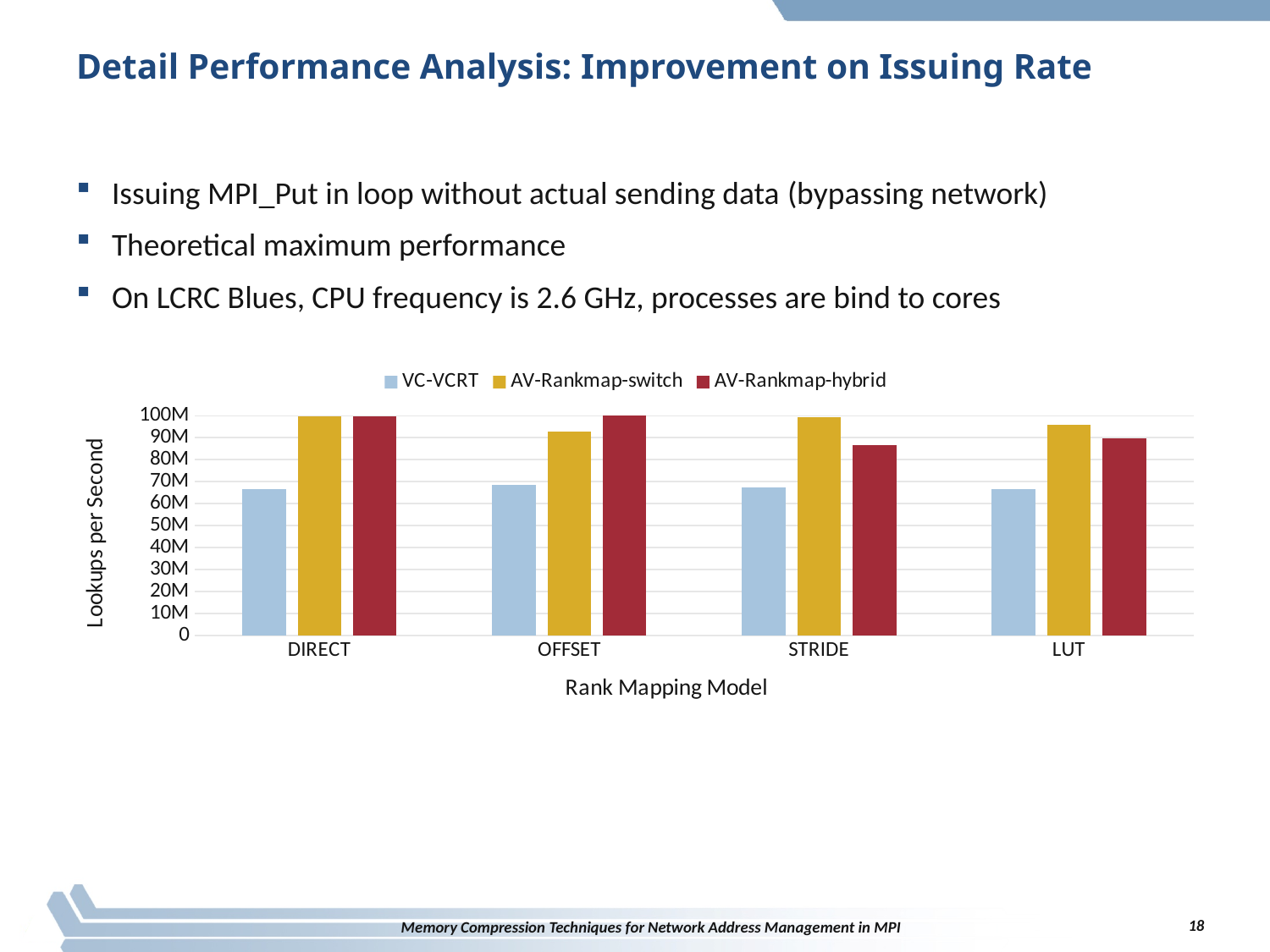
Which series has the lowest value in every rank mapping model? VC-VCRT What kind of chart is shown on the slide? bar chart What is the title of the x axis? Rank Mapping Model How many rank mapping models are shown on the x axis? 4 Is the VC-VCRT value for DIRECT greater or less than 70M? less Is the AV-Rankmap-hybrid value for STRIDE greater or less than 80M? greater What is the title of the y axis? Lookups per Second How many series does the legend list? 3 Is the VC-VCRT value for OFFSET greater or less than 60M? greater For STRIDE, which is larger: AV-Rankmap-switch or AV-Rankmap-hybrid? AV-Rankmap-switch For OFFSET, which is larger: AV-Rankmap-switch or AV-Rankmap-hybrid? AV-Rankmap-hybrid